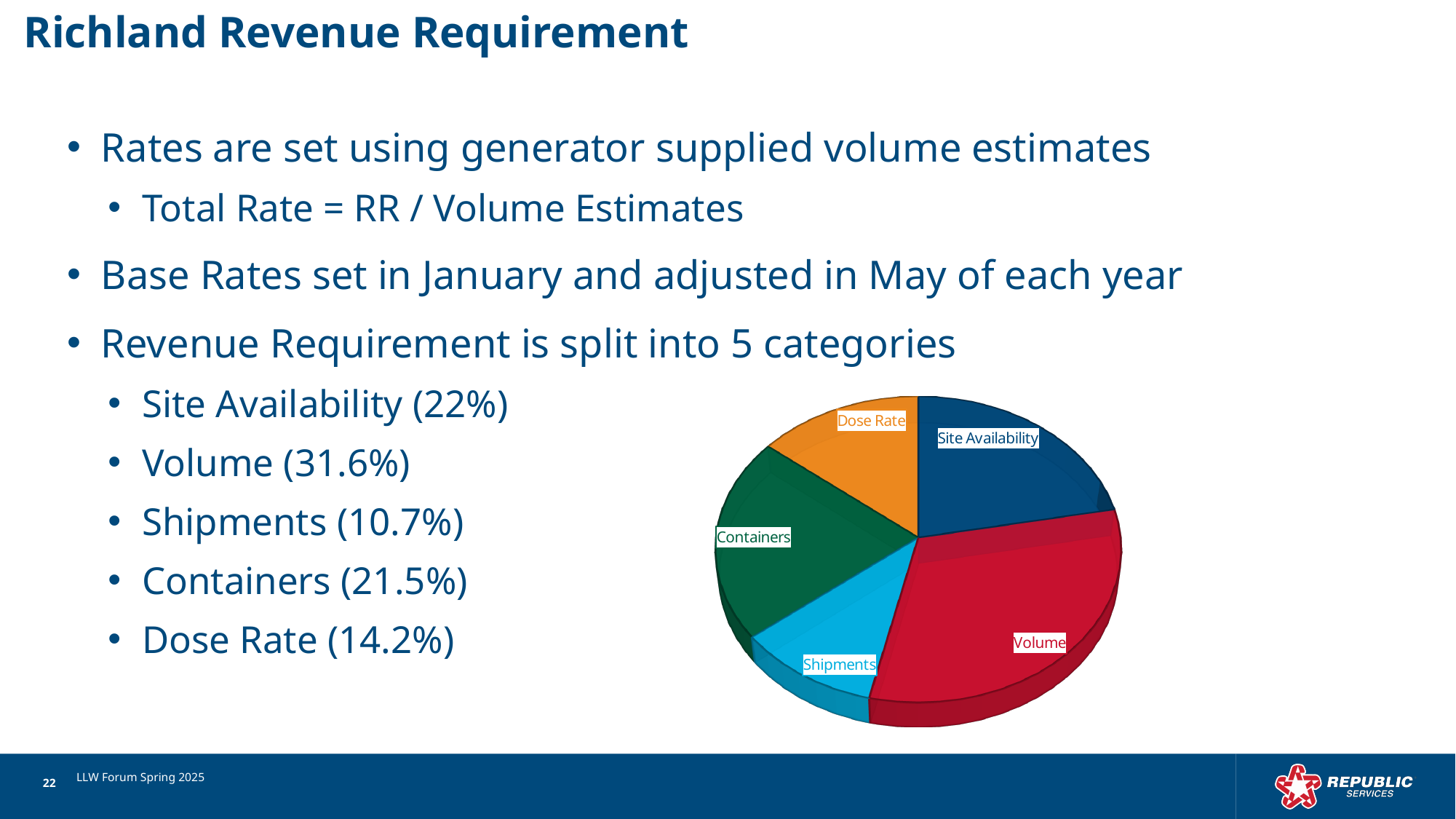
What share of the Revenue Requirement does Containers represent? 21.5% Which slice is larger, Containers or Shipments? Containers How many slices does the pie chart have? 5 What colour is the Volume slice in the pie chart? Red Which slice is larger, Volume or Dose Rate? Volume What kind of chart is shown on the slide? Pie chart Which category has the smallest slice of the pie chart? Shipments What share of the Revenue Requirement does Site Availability represent? 22% Which category has the largest slice of the pie chart? Volume What is the difference in percentage points between the Volume share and the Shipments share? 20.9% What share of the Revenue Requirement does Dose Rate represent? 14.2%